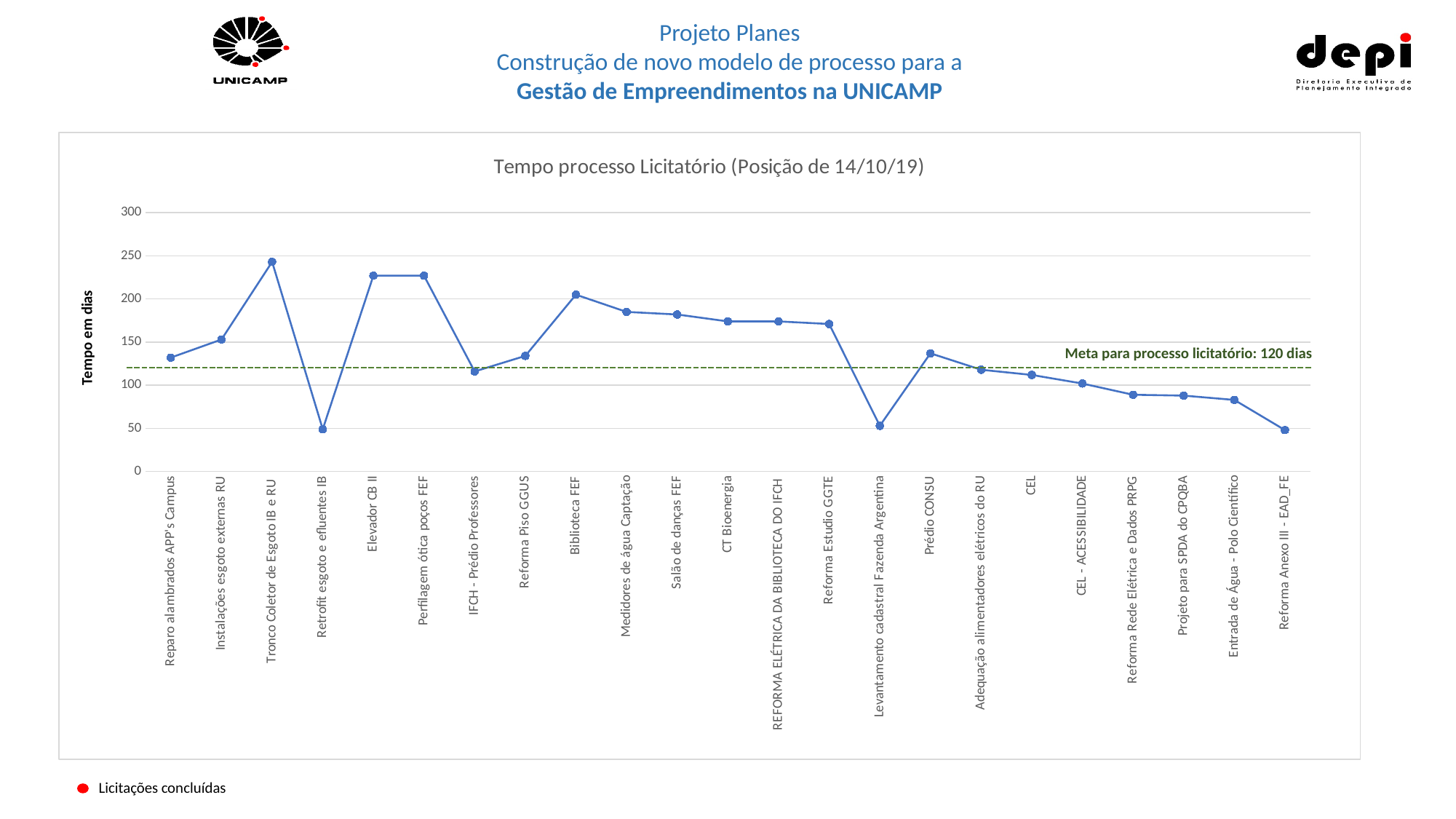
What is the target value for the bidding process shown by the dashed line? 120 dias How many projects are plotted along the x axis? 23 What is the title of the chart? Tempo processo Licitatório (Posição de 14/10/19) Which project has the highest value in the chart? Tronco Coletor de Esgoto IB e RU Do the values rise or fall from Biblioteca FEF to Reforma Estudio GGTE? fall Which is larger, the value for Tronco Coletor de Esgoto IB e RU or the value for Elevador CB II? Tronco Coletor de Esgoto IB e RU What kind of chart is shown on the slide? line chart Is the value for Elevador CB II greater or less than 200? greater Is the value for Retrofit esgoto e efluentes IB greater or less than 100? less Is the value for Levantamento cadastral Fazenda Argentina greater or less than 100? less Which is larger, the value for Biblioteca FEF or the value for Medidores de água Captação? Biblioteca FEF